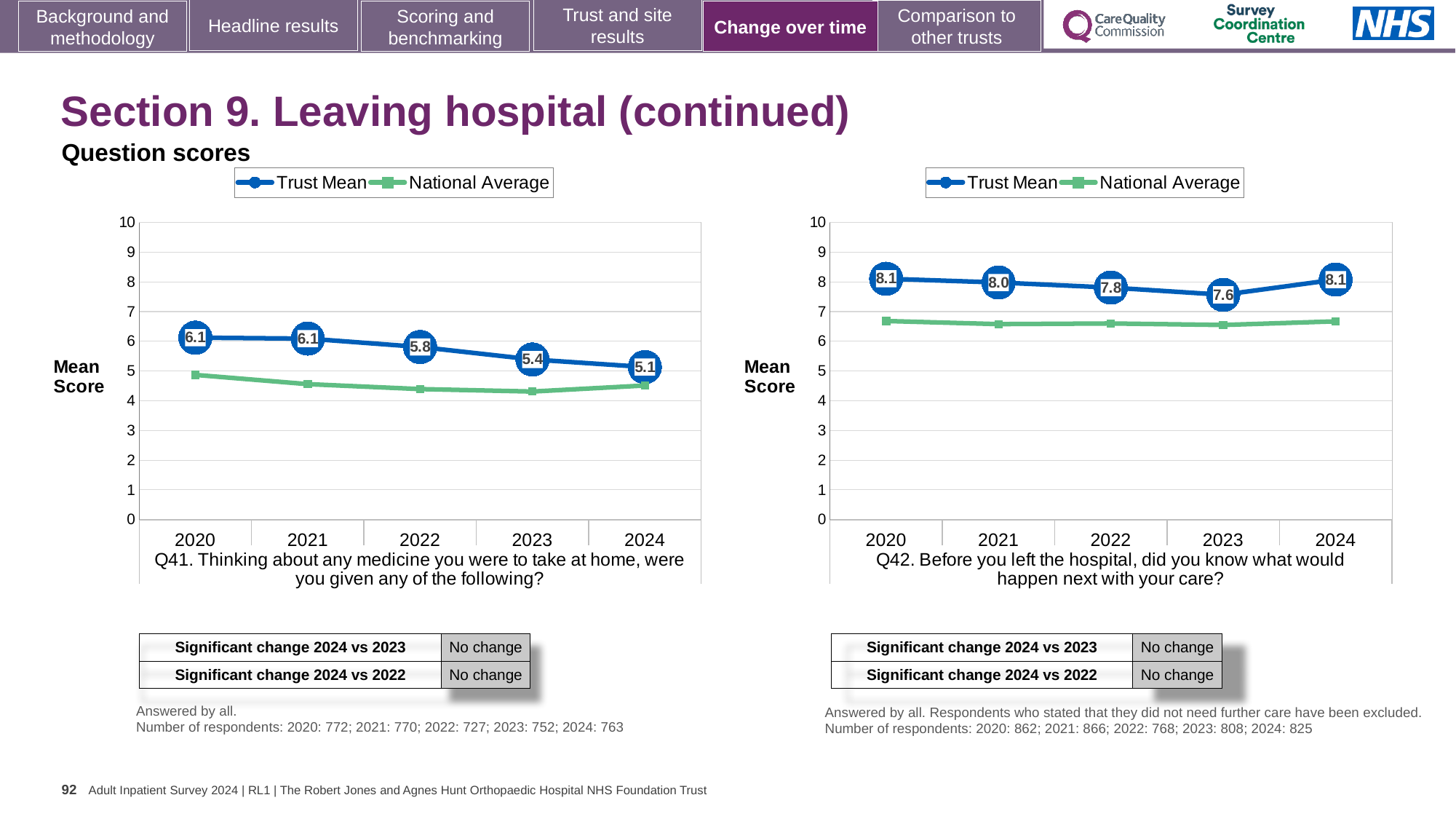
In the Q42 chart (right), is the Trust Mean score for 2022 higher or lower than the Trust Mean score for 2023? higher In the Q42 chart (right), which year has the lowest Trust Mean score? 2023 In the Q41 chart (left), what is the Trust Mean score for 2024? 5.1 In the Q41 chart (left), which year has the lowest Trust Mean score? 2024 In the Q42 chart (right), is the National Average value for 2024 greater or less than 6? greater In the Q41 chart (left), is the National Average value for 2020 greater or less than 5? less What type of chart is used for Q41 (left)? Line chart In the Q41 chart (left), what is the difference between the Trust Mean scores for 2020 and 2024? 1.0 How many series does the legend of the Q42 chart (right) list? 2 How many years are shown on the x axis of the Q41 chart (left)? 5 In the Q42 chart (right), what is the difference between the Trust Mean scores for 2024 and 2023? 0.5 In the Q42 chart (right), what is the Trust Mean score for 2023? 7.6